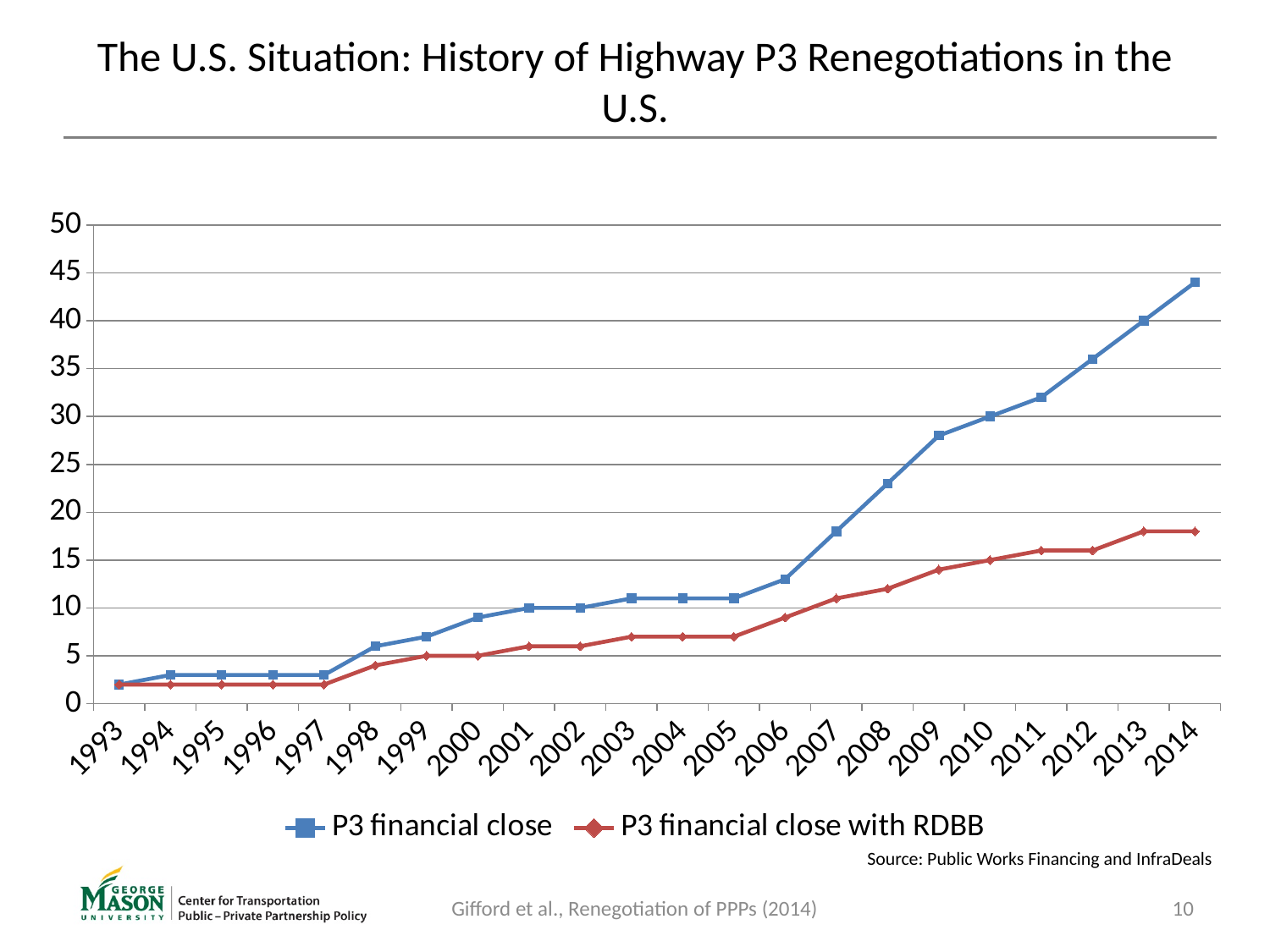
What is the value of P3 financial close in 2010? 30 What is the value of P3 financial close with RDBB in 2010? 15 What is the value of P3 financial close in 2013? 40 How many series does the legend list? 2 Do the values of P3 financial close generally rise or fall from 1993 to 2014? rise Is the value of P3 financial close in 2007 greater or less than 15? greater Which series has the higher value in 2012, P3 financial close or P3 financial close with RDBB? P3 financial close Is the value of P3 financial close in 2014 greater or less than 40? greater How many years are plotted along the x axis? 22 What kind of chart is shown on the slide? line chart Is the value of P3 financial close with RDBB in 2014 greater or less than 20? less In which year does P3 financial close reach its highest value? 2014